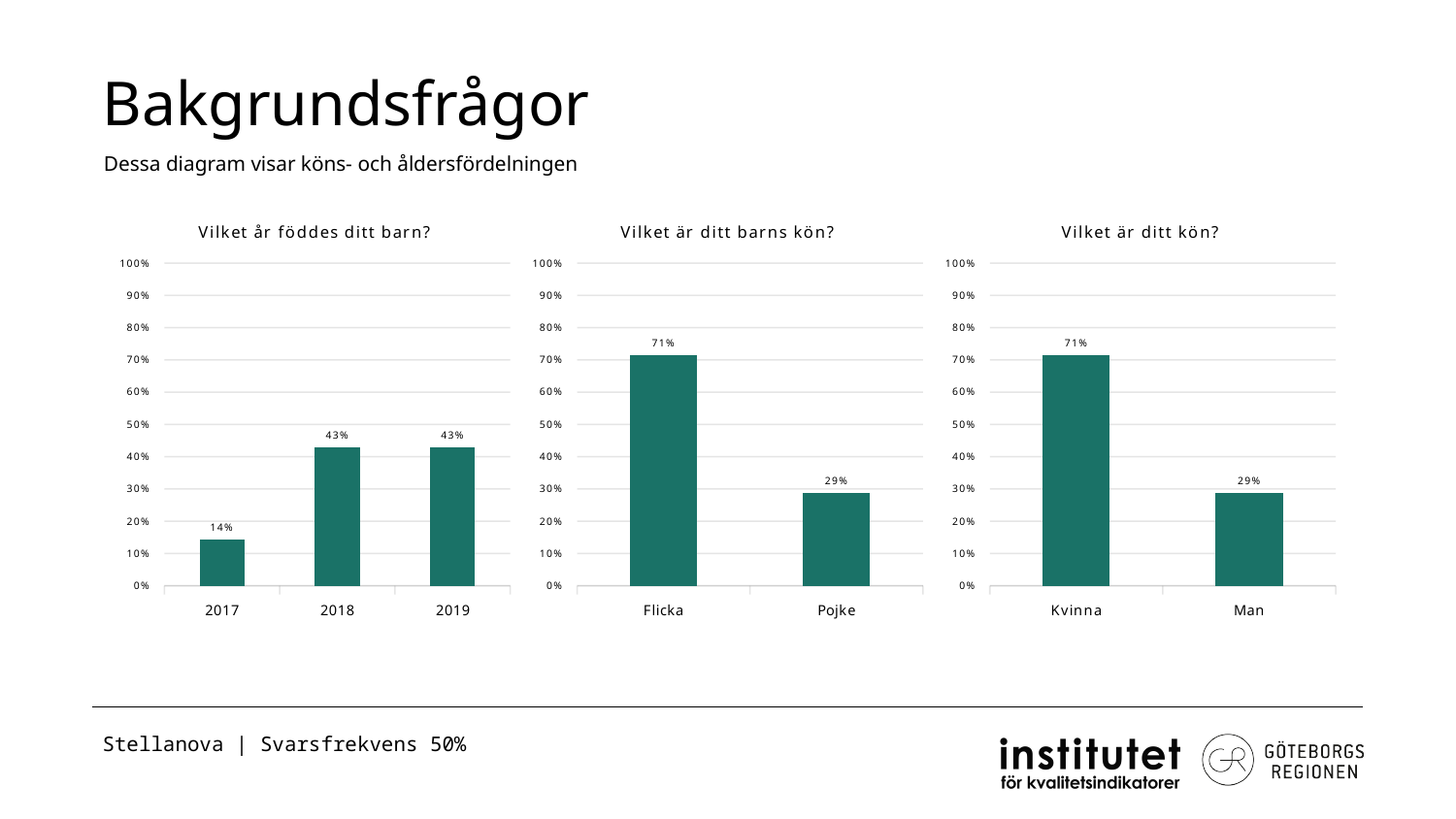
In the chart 'Vilket är ditt kön?', which is larger, Kvinna or Man? Kvinna In the chart 'Vilket är ditt barns kön?', which category is highest? Flicka In the chart 'Vilket år föddes ditt barn?', what is the value for 2018? 43% In the chart 'Vilket år föddes ditt barn?', which year has the lowest value? 2017 What kind of chart is 'Vilket är ditt kön?'? Bar chart In the chart 'Vilket är ditt barns kön?', what is the value for Flicka? 71% In the chart 'Vilket är ditt kön?', what is the value for Man? 29% In the chart 'Vilket år föddes ditt barn?', what is the value for 2017? 14% In the chart 'Vilket år föddes ditt barn?', what is the difference between the values for 2018 and 2017? 29% In the chart 'Vilket är ditt barns kön?', what is the value for Pojke? 29% In the chart 'Vilket år föddes ditt barn?', how many years are shown on the x axis? 3 In the chart 'Vilket är ditt kön?', what is the difference between the values for Kvinna and Man? 42%